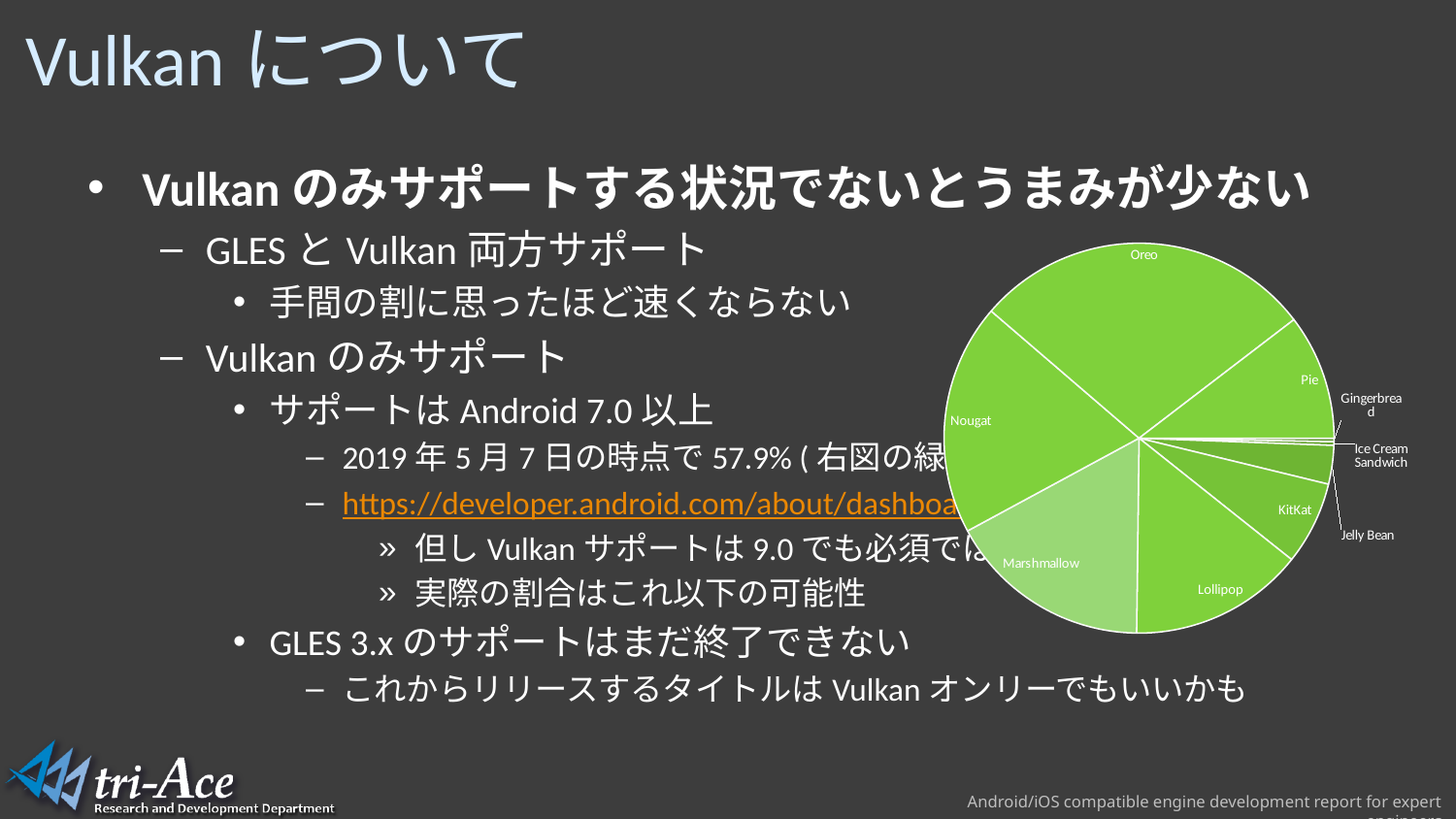
In the pie chart, which is larger, the Marshmallow slice or the Jelly Bean slice? Marshmallow What colour family is used for the slices of the pie chart? green In the pie chart, which is larger, the Oreo slice or the Lollipop slice? Oreo Which slice of the pie chart is the largest? Oreo How many slices does the pie chart have? 9 In the pie chart, which is larger, the Lollipop slice or the Ice Cream Sandwich slice? Lollipop Which Android version slice is labelled at the top of the pie chart? Oreo What kind of chart is shown on the right side of the slide? pie chart